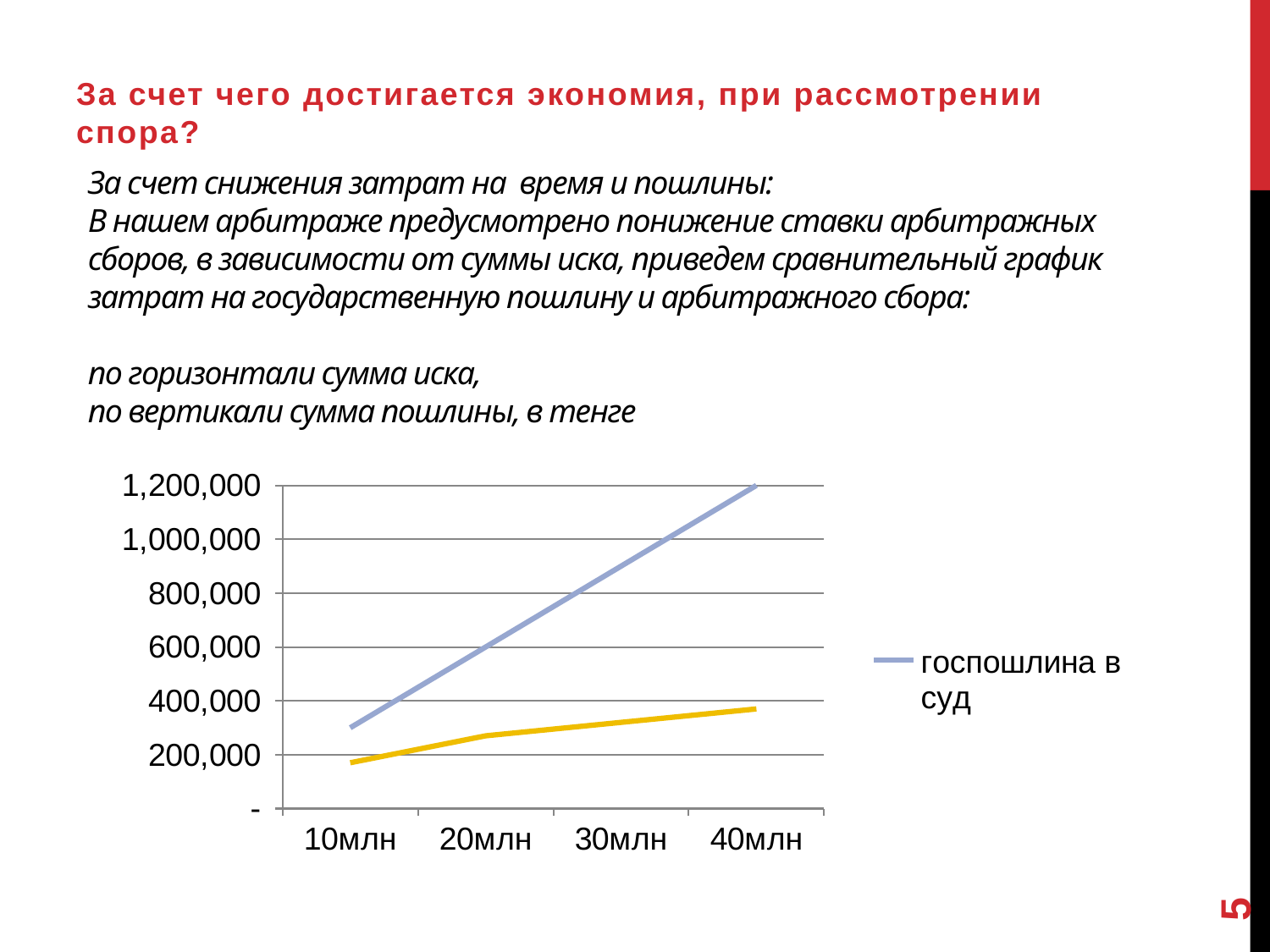
What are the categories on the x axis? 10млн, 20млн, 30млн, 40млн What is the value of госпошлина в суд at 40млн? 1,200,000 How many claim-amount categories are shown on the x axis? 4 What kind of chart is shown on the slide? line chart At which claim amount is госпошлина в суд lowest? 10млн Does the госпошлина в суд line rise or fall as the claim amount increases from 10млн to 40млн? rises At 40млн, which line is higher: the госпошлина в суд line or the yellow line? госпошлина в суд Is the value of the yellow line at 40млн greater or less than 400,000? less Is the value for госпошлина в суд at 10млн greater or less than 400,000? less Is the value for госпошлина в суд at 30млн greater or less than 800,000? greater At which claim amount is госпошлина в суд highest? 40млн What colour is the госпошлина в суд line? blue